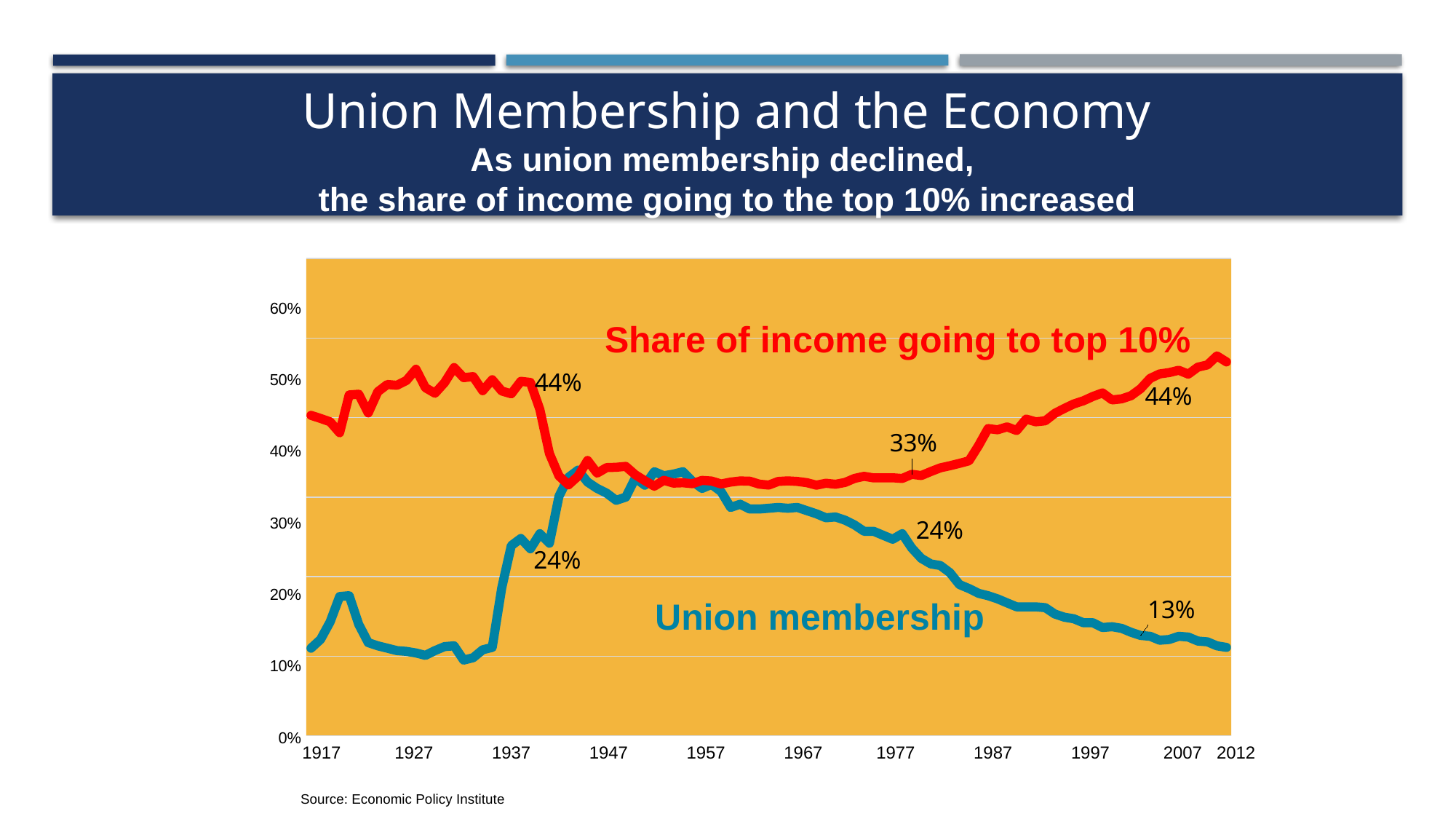
What is the last labelled value on the Union membership line? 13% What type of chart is shown on the slide? line chart What is the first labelled value on the Share of income going to top 10% line? 44% How many data series are plotted on the chart? 2 Does the Union membership line rise or fall from 1957 to 2012? fall Near 1977, what is the difference between the labelled Share of income going to top 10% value and the labelled Union membership value? 9 percentage points What colour is the Union membership line? blue Near 1977, which series has the higher labelled value, Share of income going to top 10% or Union membership? Share of income going to top 10% What is the labelled value on the Share of income going to top 10% line near 1977? 33% What is the labelled value on the Union membership line near 1977? 24% Is the Union membership value in 2012 greater or less than 20%? less Is the Share of income going to top 10% value in 2012 greater or less than 50%? greater